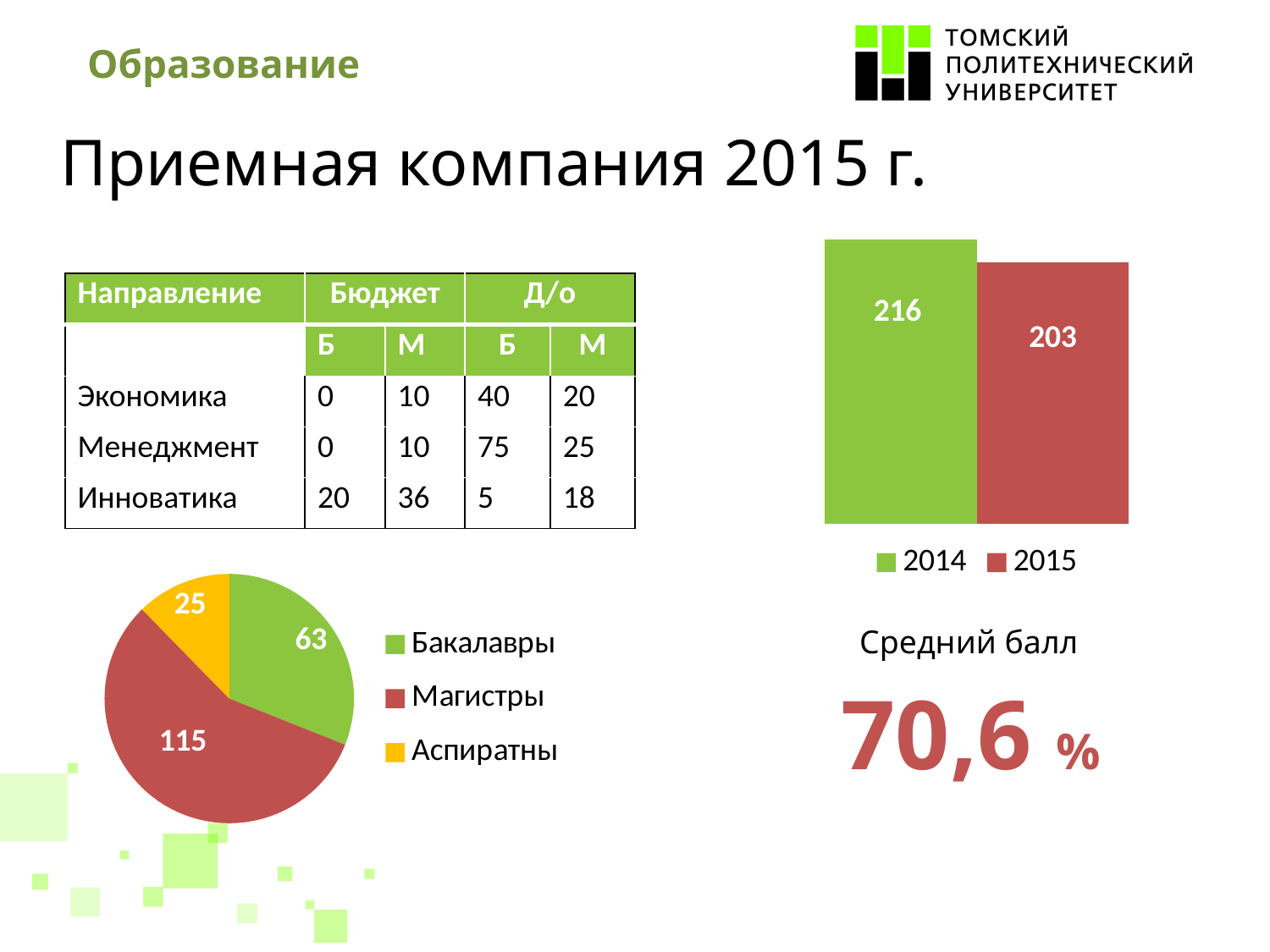
In the pie chart at the bottom left, what is the difference between the Магистры and Бакалавры values? 52 In the bar chart on the right, what is the value for 2015? 203 In the bar chart on the right, how many series does the legend list? 2 In the pie chart at the bottom left, what is the value for Магистры? 115 In the pie chart at the bottom left, which category has the largest slice? Магистры In the pie chart at the bottom left, how many categories are shown? 3 What kind of chart is shown on the right of the slide? bar chart In the pie chart at the bottom left, which category has the smallest slice? Аспиратны In the bar chart on the right, what is the value for 2014? 216 In the pie chart at the bottom left, what is the value for Бакалавры? 63 In the bar chart on the right, what is the difference between the 2014 and 2015 values? 13 In the bar chart on the right, which year has the higher value? 2014